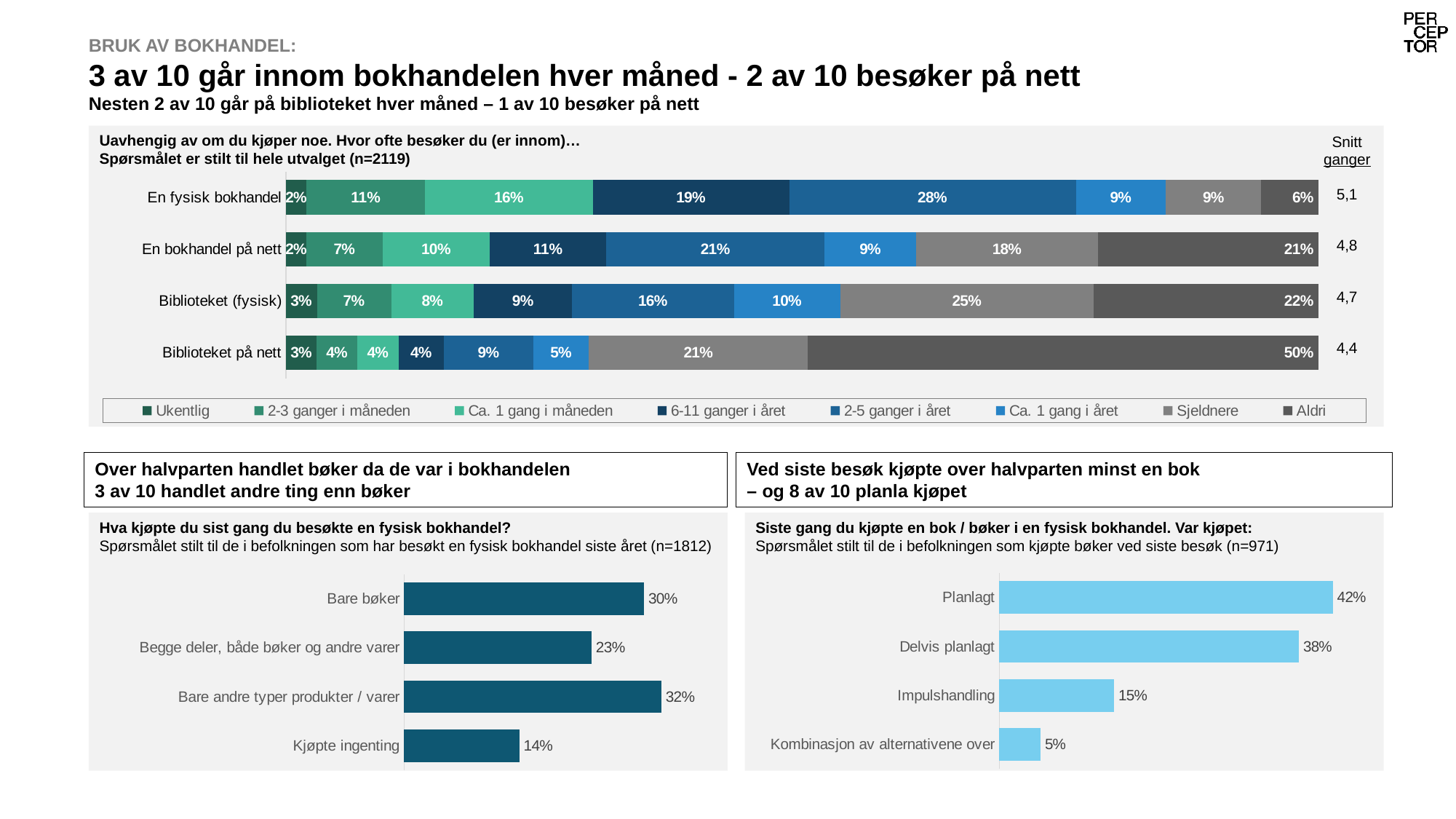
In the top chart (Hvor ofte besøker du), what is the 'Aldri' value for 'Biblioteket på nett'? 50% In the top chart (Hvor ofte besøker du), how many series does the legend list? 8 In the top chart (Hvor ofte besøker du), what is the '2-5 ganger i året' value for 'En fysisk bokhandel'? 28% In the top chart (Hvor ofte besøker du), what is the difference between the 'Sjeldnere' values for 'Biblioteket (fysisk)' and 'En fysisk bokhandel'? 16% In the top chart (Hvor ofte besøker du), what is the 'Snitt ganger' value shown for 'En bokhandel på nett'? 4,8 In the bottom-left chart (Hva kjøpte du sist gang du besøkte en fysisk bokhandel?), what is the value for 'Kjøpte ingenting'? 14% In the bottom-right chart (Siste gang du kjøpte en bok / bøker i en fysisk bokhandel), what is the difference between 'Planlagt' and 'Delvis planlagt'? 4% In the top chart (Hvor ofte besøker du), how many categories (rows) are plotted? 4 In the top chart (Hvor ofte besøker du), which category has the highest 'Aldri' value? Biblioteket på nett In the bottom-left chart (Hva kjøpte du sist gang du besøkte en fysisk bokhandel?), what kind of chart is it? Bar chart In the bottom-right chart (Siste gang du kjøpte en bok / bøker i en fysisk bokhandel), which category has the lowest value? Kombinasjon av alternativene over In the bottom-left chart (Hva kjøpte du sist gang du besøkte en fysisk bokhandel?), which category has the highest value? Bare andre typer produkter / varer